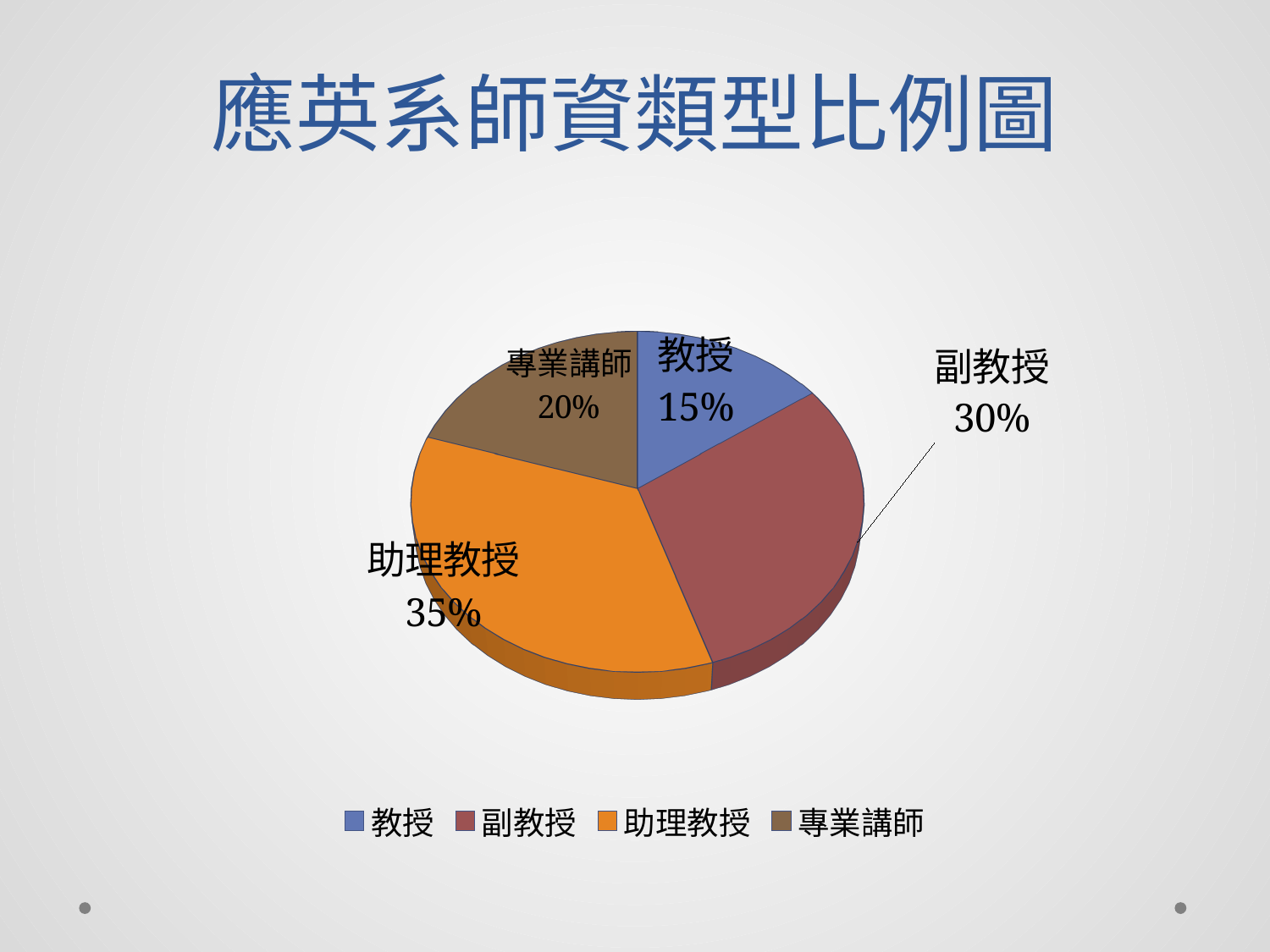
Which category has the largest share of the pie? 助理教授 How many categories are shown in the pie chart? 4 What percentage of the pie is 副教授? 30% Which is larger, the share for 副教授 or the share for 專業講師? 副教授 Which category has the smallest share of the pie? 教授 What is the difference in percentage points between 助理教授 and 教授? 20 What percentage of the pie is 教授? 15% What kind of chart is shown on the slide? pie chart What is the title of the chart? 應英系師資類型比例圖 What is the difference in percentage points between 副教授 and 專業講師? 10 What percentage of the pie is 助理教授? 35% What percentage of the pie is 專業講師? 20%